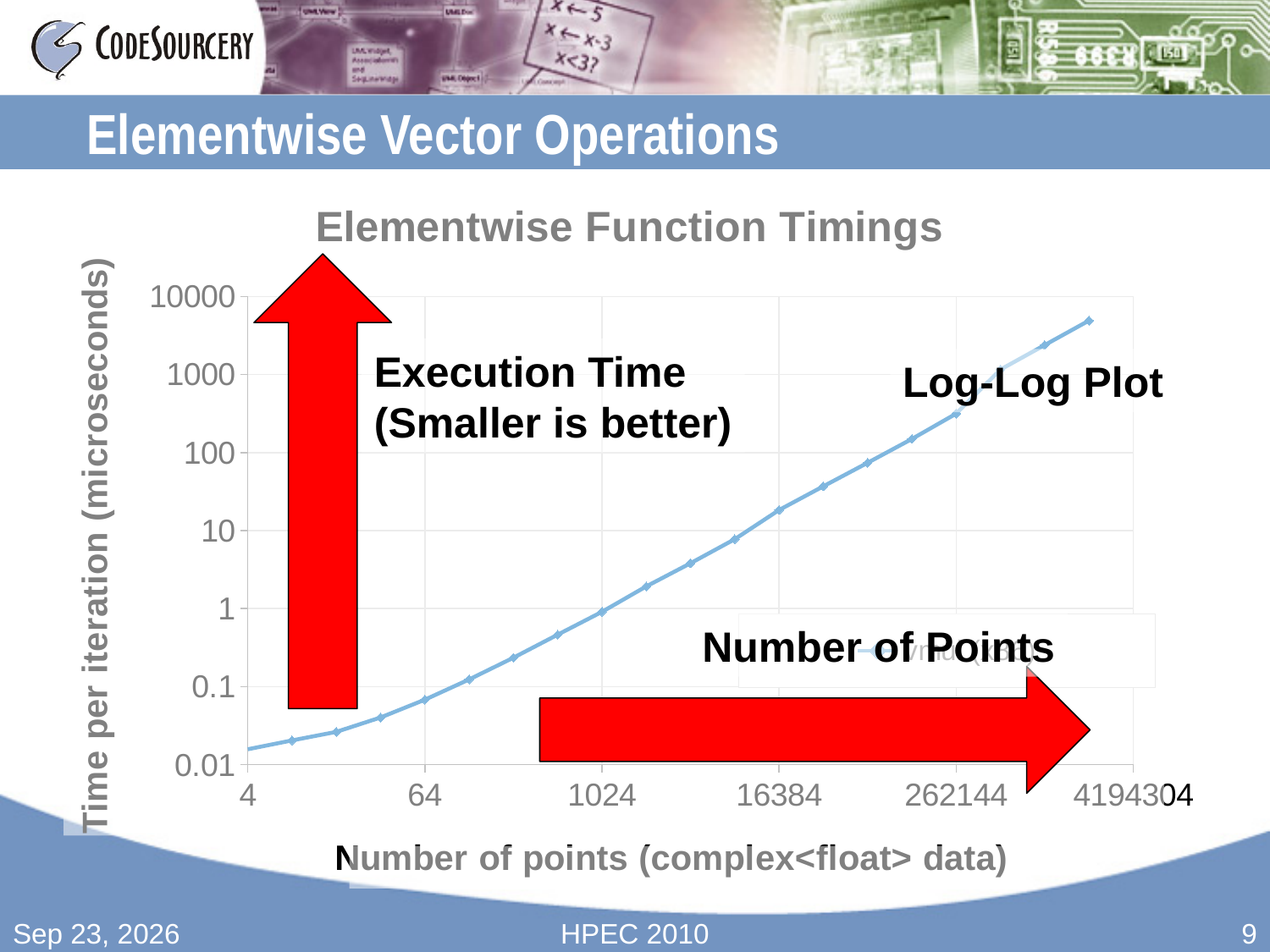
Is the time per iteration at 4 points greater or less than 0.1? less Is the time per iteration at 64 points greater or less than 0.1? less Which has the larger time per iteration: 64 points or 16384 points? 16384 points Is the time per iteration at 16384 points greater or less than 10? greater What is the label of the y axis of the chart? Time per iteration (microseconds) What kind of chart is shown on the slide? line chart At which number of points is the time per iteration lowest? 4 Does the time per iteration rise or fall as the number of points increases along the x axis? rise What is the title of the chart? Elementwise Function Timings